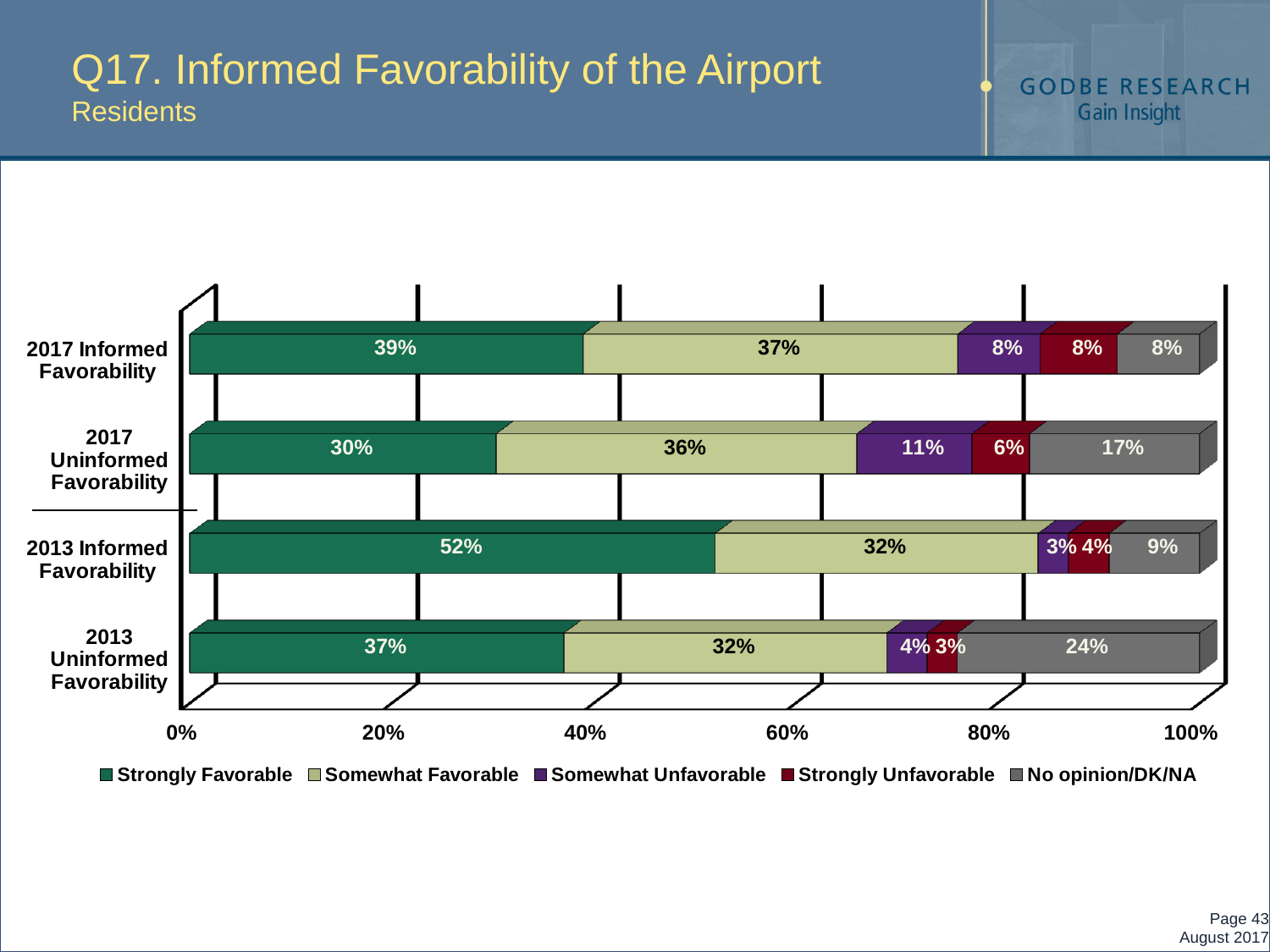
What is the title of the slide? Q17. Informed Favorability of the Airport How many categories are shown on the chart? 4 What type of chart is shown on the slide? Stacked bar chart What is the No opinion/DK/NA value for 2013 Uninformed Favorability? 24% What is the total of the stacked bar for 2017 Uninformed Favorability? 100% What is the Strongly Favorable value for 2017 Informed Favorability? 39% How many series does the legend list? 5 Which category has the highest Strongly Favorable value? 2013 Informed Favorability Which is larger: the No opinion/DK/NA value for 2017 Uninformed Favorability or for 2013 Informed Favorability? 2017 Uninformed Favorability Which category has the lowest Strongly Favorable value? 2017 Uninformed Favorability What is the difference between the Strongly Favorable values for 2013 Informed Favorability and 2017 Informed Favorability? 13% What is the Somewhat Unfavorable value for 2017 Uninformed Favorability? 11%